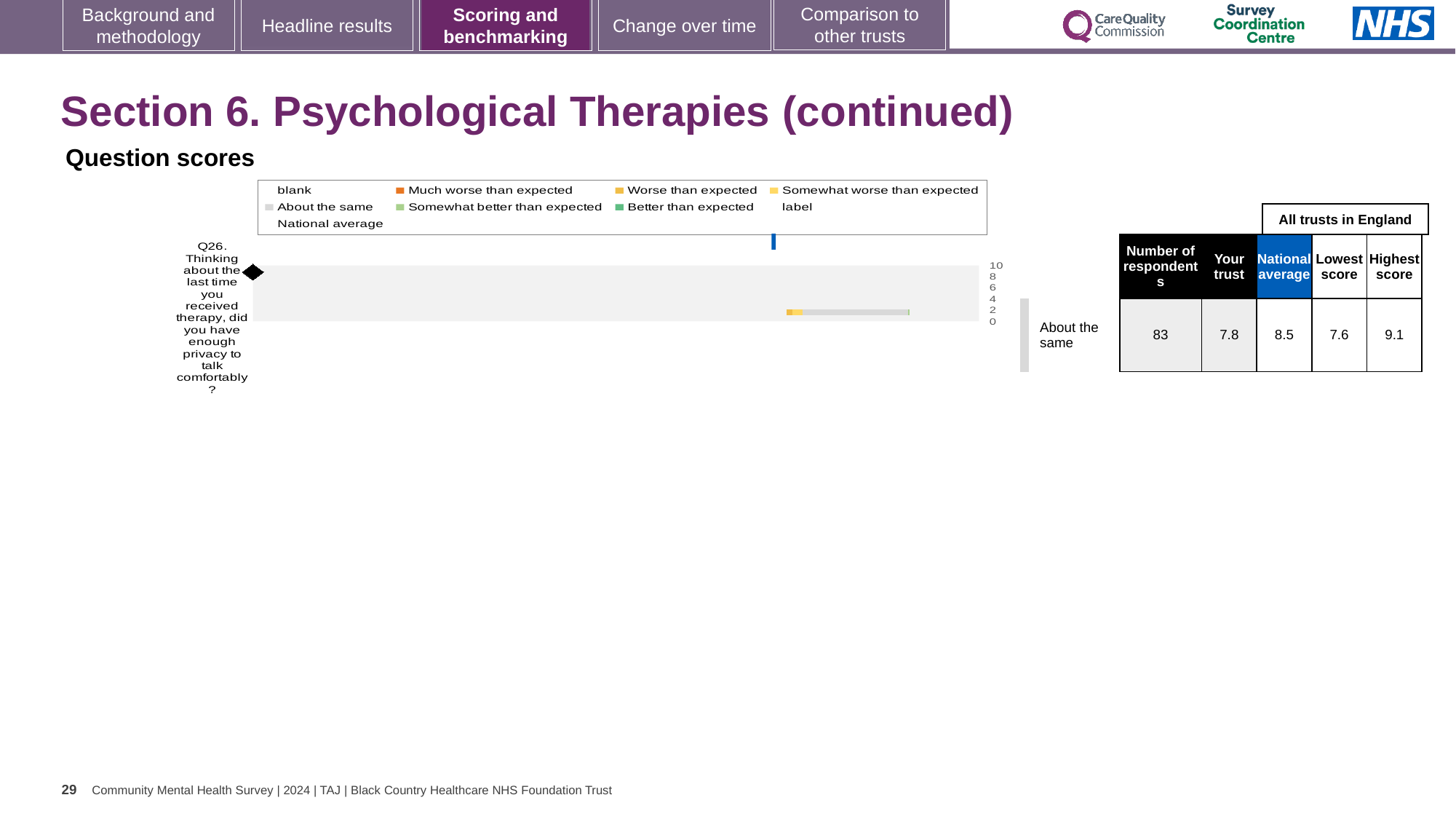
What is the highest value shown on the chart's axis? 10 According to the table next to the chart, what is the Lowest score among all trusts in England for Q26? 7.6 According to the table next to the chart, what is the 'Your trust' score for Q26? 7.8 According to the table next to the chart, what is the Highest score among all trusts in England for Q26? 9.1 What kind of chart is shown under 'Question scores'? bar chart How many questions are plotted in the Question scores chart? 1 What is the difference between the Highest score and the Lowest score for Q26 in the table? 1.5 Which is larger for Q26: the 'Your trust' score or the National average? National average How many respondents are listed for Q26 in the table next to the chart? 83 What benchmark category is given for Q26 beside the chart? About the same According to the table next to the chart, what is the National average score for Q26? 8.5 Which question number is plotted in the Question scores chart? Q26